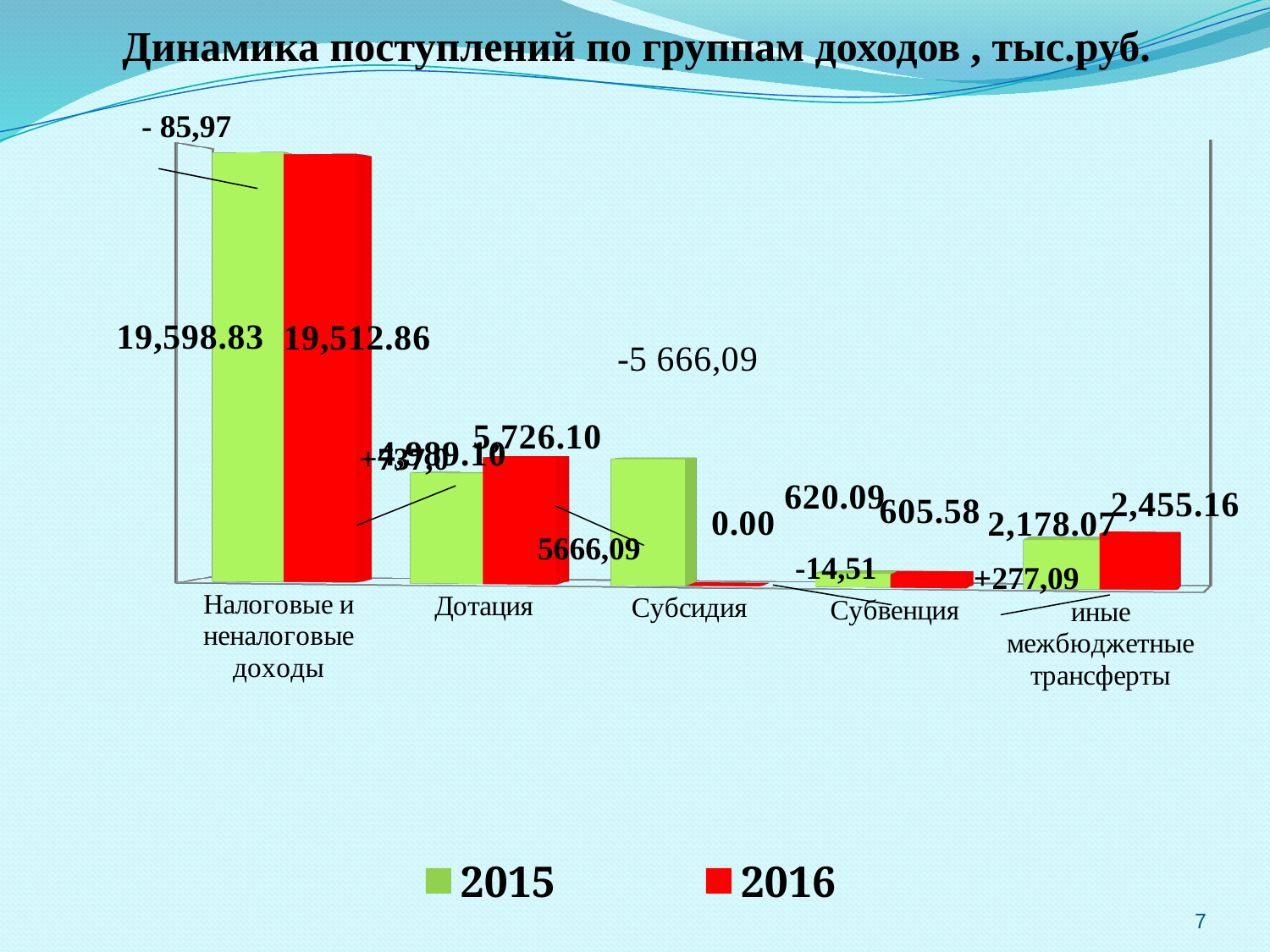
What is the 2016 value for иные межбюджетные трансферты? 2,455.16 How many series does the legend list? 2 What colour represents the 2016 series in the legend? red What is the 2016 value for Субсидия? 0.00 What is the 2016 value for Дотация? 5,726.10 What is the 2016 value for Налоговые и неналоговые доходы? 19,512.86 For Субвенция, which year has the larger value, 2015 or 2016? 2015 What is the 2015 value for Субвенция? 620.09 How many income groups (categories) are shown on the x axis? 5 Which category has the highest 2016 value? Налоговые и неналоговые доходы What is the 2015 value for Налоговые и неналоговые доходы? 19,598.83 What kind of chart is shown on the slide? bar chart